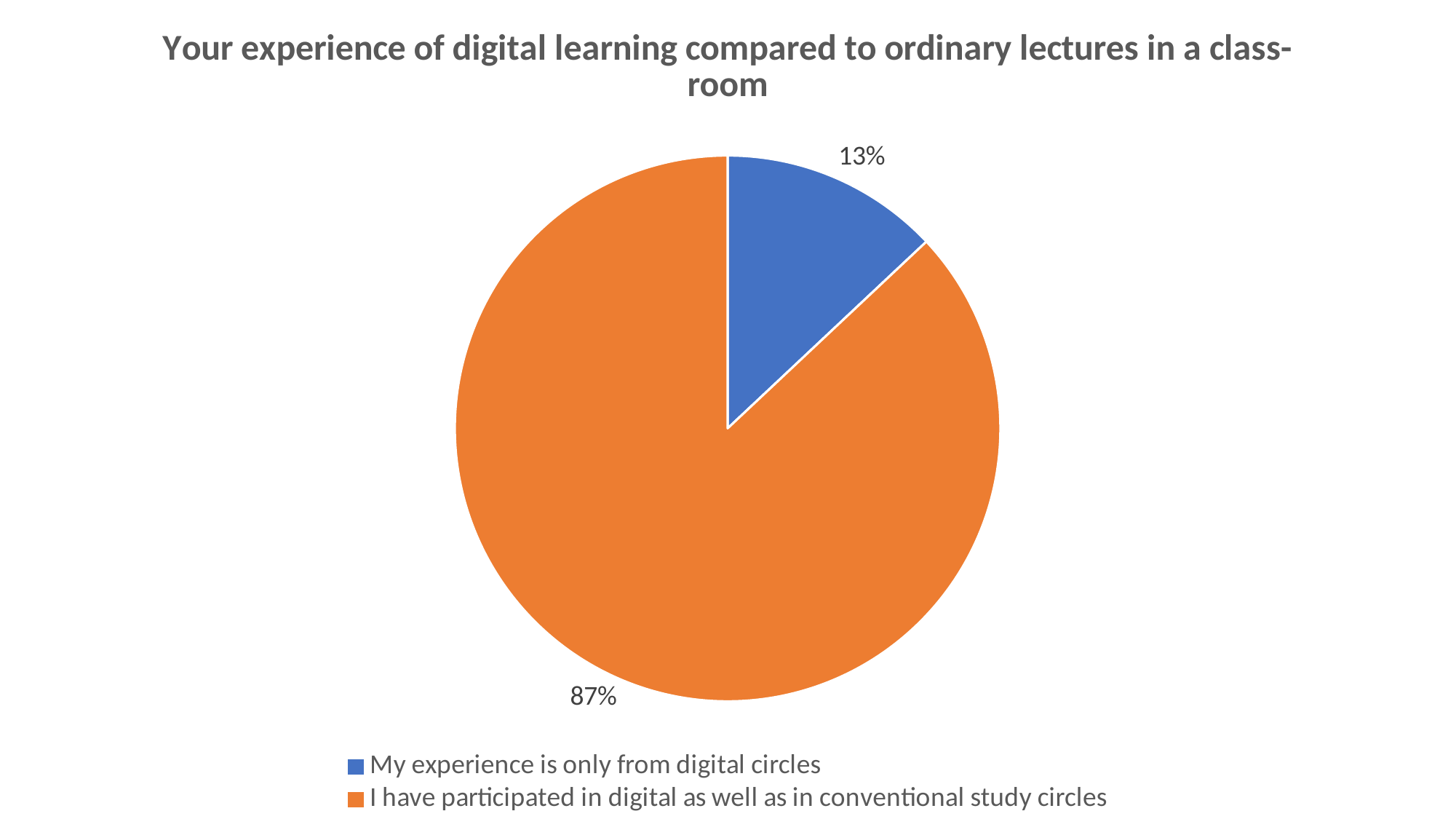
Which is larger: the slice for "My experience is only from digital circles" or the slice for "I have participated in digital as well as in conventional study circles"? I have participated in digital as well as in conventional study circles What colour is the slice for "My experience is only from digital circles"? blue How many slices does the pie chart have? 2 What share of the pie is labelled "My experience is only from digital circles"? 13% How many entries does the legend list? 2 Which category has the smallest slice of the pie? My experience is only from digital circles Which category has the largest slice of the pie? I have participated in digital as well as in conventional study circles What share of the pie is labelled "I have participated in digital as well as in conventional study circles"? 87% What is the difference in percentage points between the two slices? 74 What kind of chart is shown on the slide? pie chart What is the title of the chart? Your experience of digital learning compared to ordinary lectures in a class-room